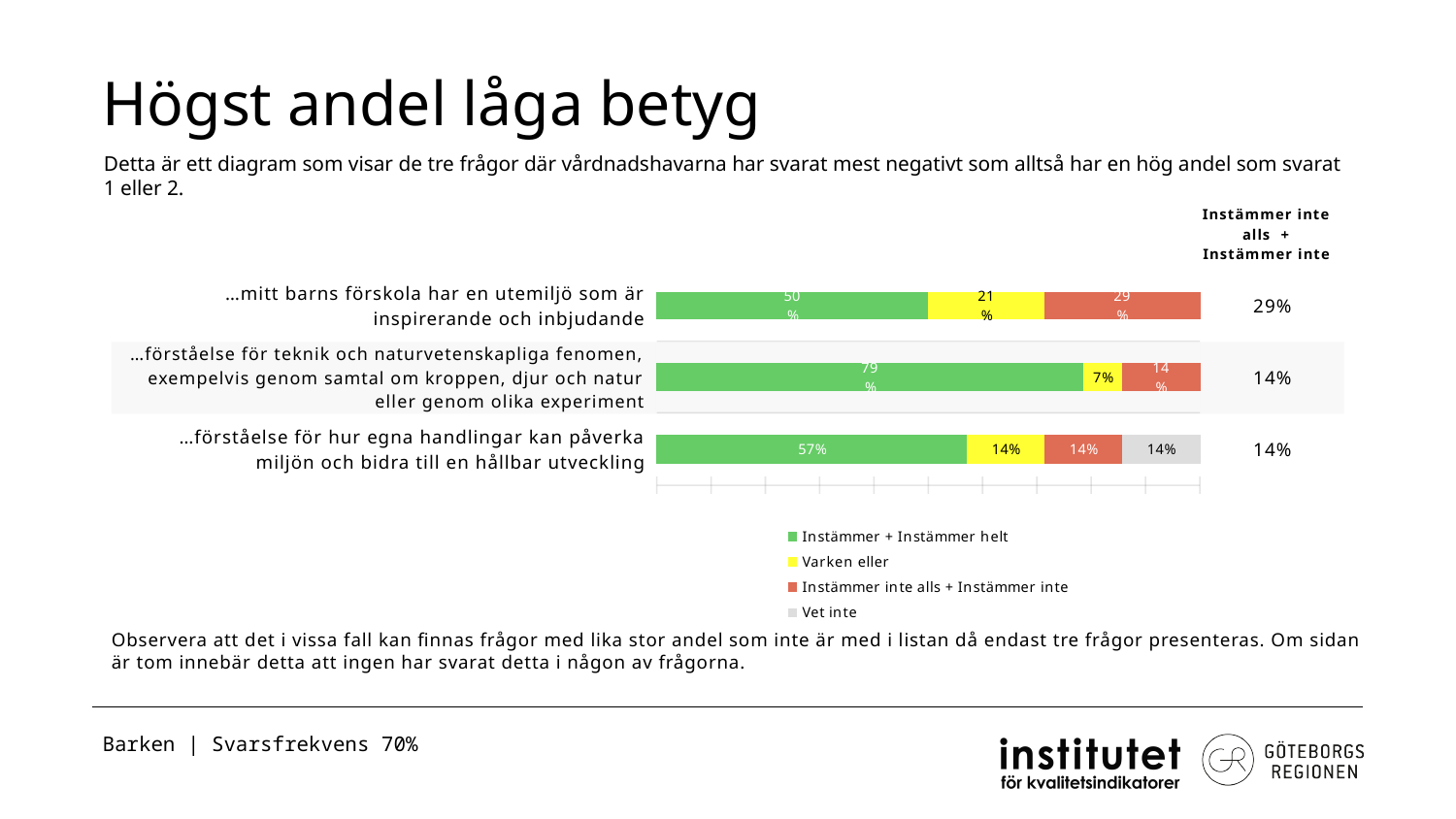
What is the 'Vet inte' share for the question about how one's own actions can affect the environment (egna handlingar)? 14% How many series does the legend list? 4 What is the 'Instämmer + Instämmer helt' share for the question about the preschool's outdoor environment (utemiljö)? 50% What is the difference in 'Instämmer + Instämmer helt' share between the teknik och naturvetenskapliga fenomen question (79%) and the utemiljö question (50%)? 29 percentage points Which question has the highest 'Instämmer inte alls + Instämmer inte' share? …mitt barns förskola har en utemiljö som är inspirerande och inbjudande Which has the larger 'Varken eller' share: the utemiljö question or the egna handlingar question? The utemiljö question How many questions (categories) are plotted in the chart? 3 What kind of chart is shown on the slide? Bar chart What is the 'Varken eller' share for the question about understanding of technology and natural science phenomena (teknik och naturvetenskapliga fenomen)? 7% What value is shown in the right-hand column ('Instämmer inte alls + Instämmer inte') for the utemiljö question? 29% Which question has the highest 'Instämmer + Instämmer helt' share? …förståelse för teknik och naturvetenskapliga fenomen, exempelvis genom samtal om kroppen, djur och natur eller genom olika experiment What colour represents 'Varken eller' in the legend? Yellow